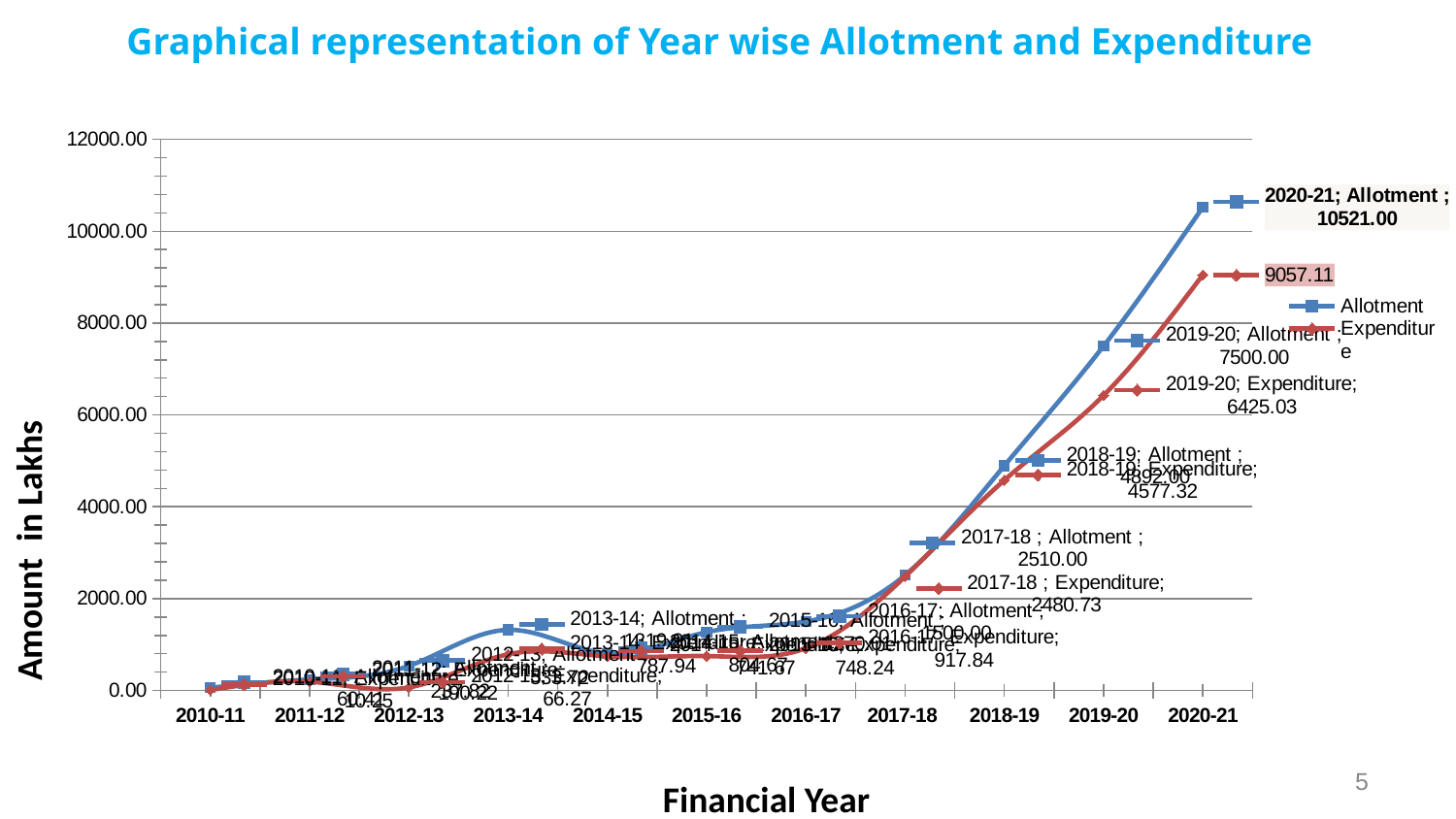
What is the Allotment value for 2019-20? 7500.00 What is the Expenditure value for 2017-18? 2480.73 What is the Expenditure value for 2019-20? 6425.03 What is the Allotment value for 2020-21? 10521.00 What type of chart is shown on the slide? Line chart What is the Expenditure value for 2020-21? 9057.11 Is the Allotment value for 2018-19 greater or less than 4000.00? greater How many series does the legend list? 2 Which financial year has the highest Allotment? 2020-21 How many financial years are shown on the x axis? 11 What is the title of the y axis? Amount in Lakhs What is the difference between Allotment and Expenditure in 2020-21? 1463.89